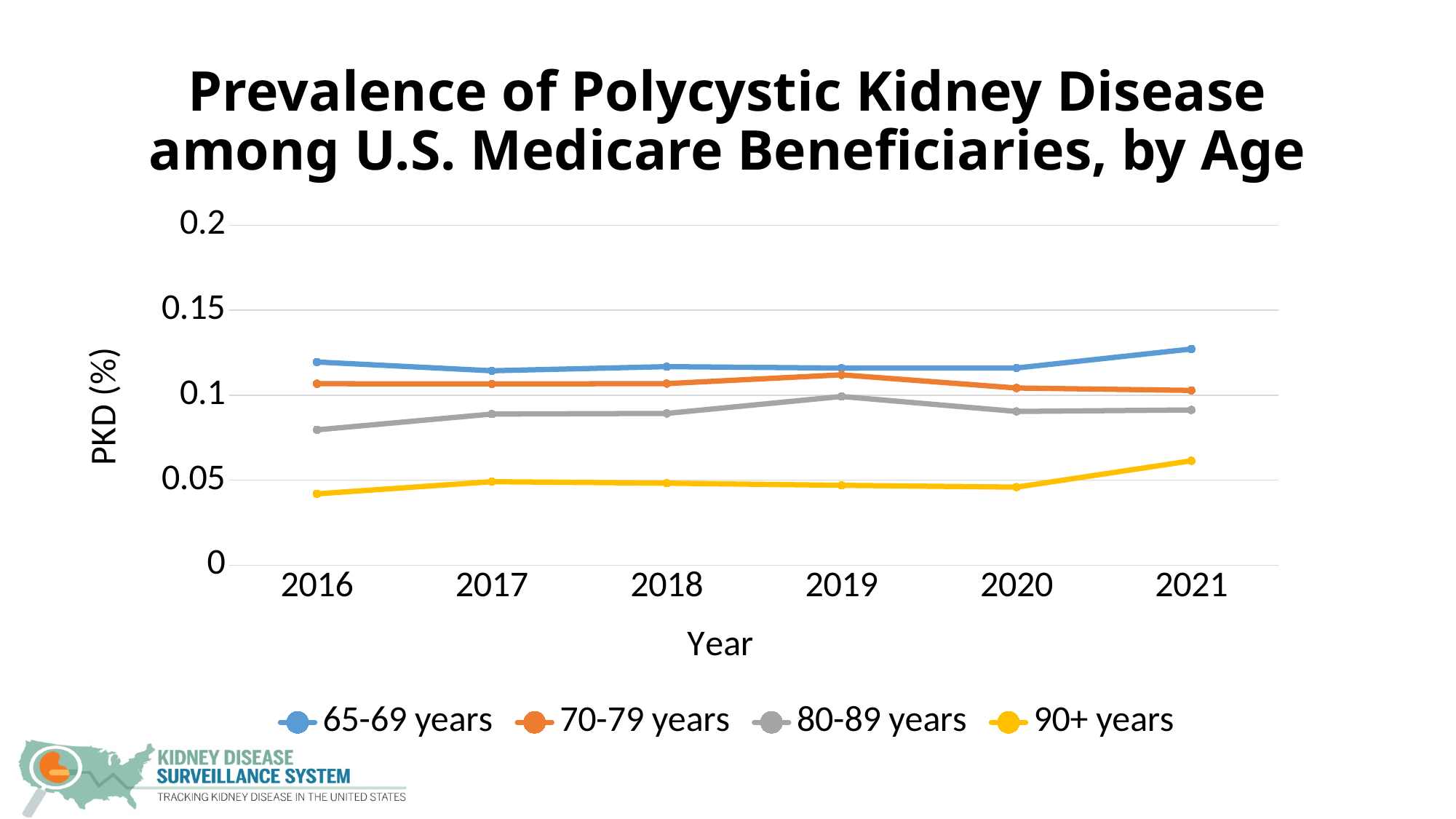
In which year is the value for the 90+ years series lowest? 2016 Is the value for 80-89 years in 2016 greater or less than 0.1? less How many years are plotted along the x axis? 6 Which age group has the lowest PKD prevalence across all years? 90+ years How many series does the legend list? 4 What is the label on the y axis? PKD (%) What kind of chart is shown on the slide? Line chart Which age group has the highest PKD prevalence across all years? 65-69 years Which is larger in 2021, the value for 65-69 years or the value for 70-79 years? 65-69 years In which year is the value for the 65-69 years series highest? 2021 Is the value for 90+ years in 2021 greater or less than 0.05? greater In which year is the value for the 80-89 years series highest? 2019